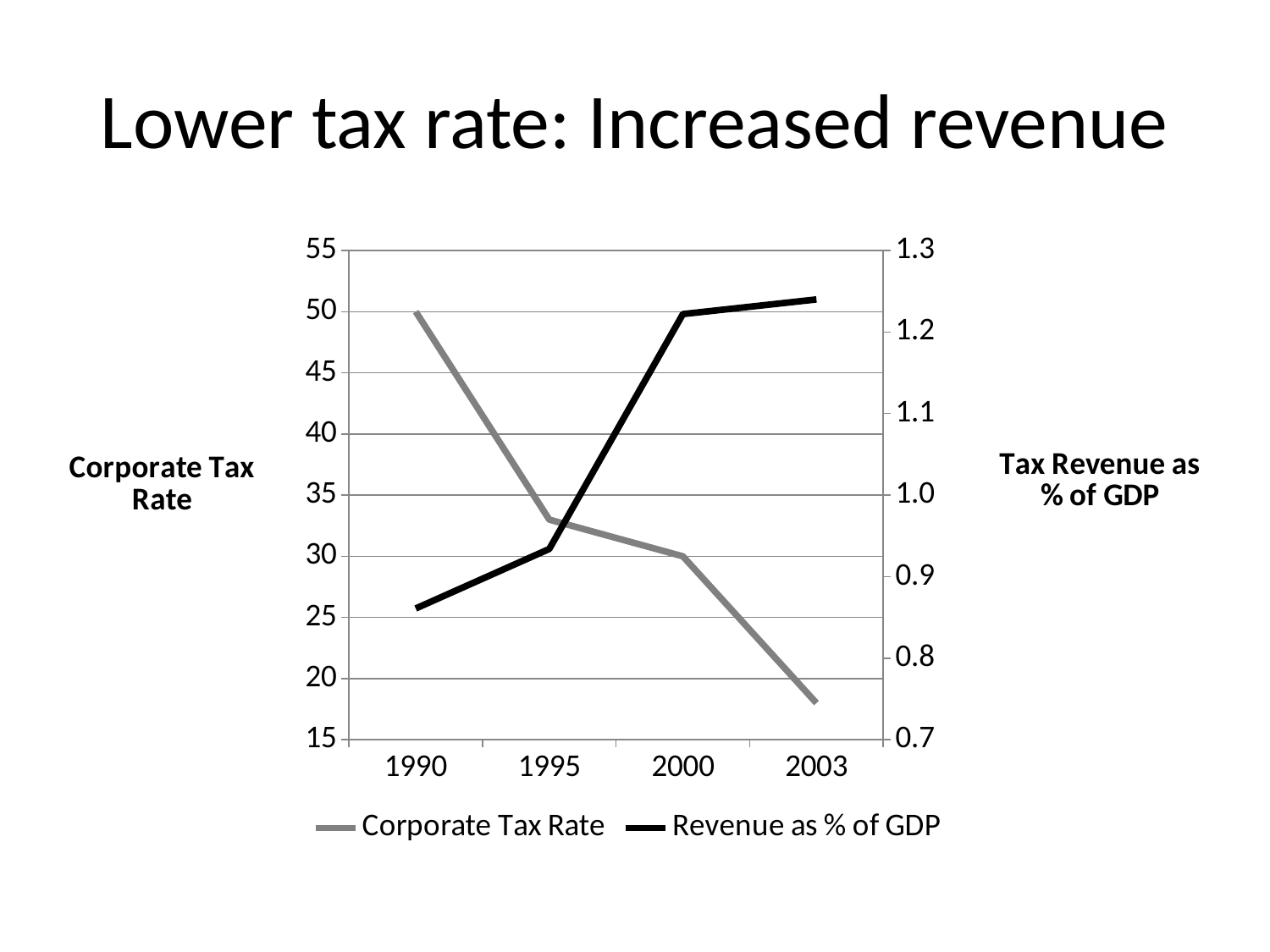
Does the Corporate Tax Rate rise or fall from 1990 to 2003? fall In which year is Revenue as % of GDP lowest? 1990 Is the Corporate Tax Rate in 2003 greater or less than 20? less Does Revenue as % of GDP rise or fall from 1990 to 2003? rise How many series does the legend list? 2 What kind of chart is shown on the slide? line chart What is the title of the slide? Lower tax rate: Increased revenue In which year is the Corporate Tax Rate highest? 1990 Is Revenue as % of GDP in 1990 greater or less than 0.9? less How many years are plotted along the x axis? 4 In which year is the Corporate Tax Rate lowest? 2003 Is Revenue as % of GDP in 2003 greater or less than 1.1? greater